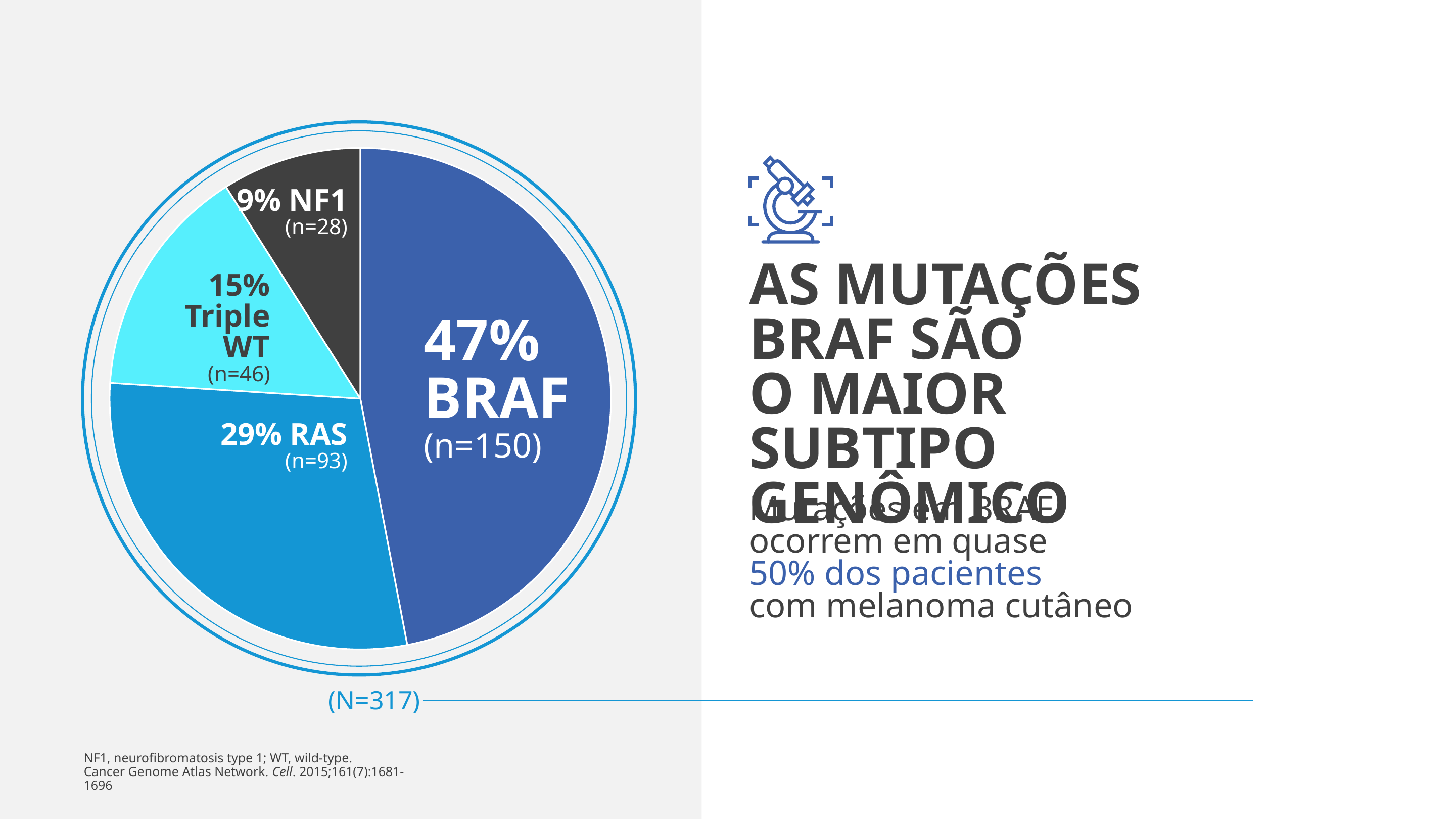
What share of the pie does BRAF represent? 47% What kind of chart is shown on the slide? pie chart Which slice of the pie chart is the largest? BRAF Which slice of the pie chart is the smallest? NF1 What share of the pie does RAS represent? 29% How many slices does the pie chart have? 4 What is the total N shown below the pie chart? N=317 Which slice is larger, RAS or Triple WT? RAS What is the difference in patient count between the RAS slice and the Triple WT slice? 47 What share of the pie does Triple WT represent? 15% What is the number of patients (n) in the NF1 slice? n=28 What is the number of patients (n) in the BRAF slice? n=150